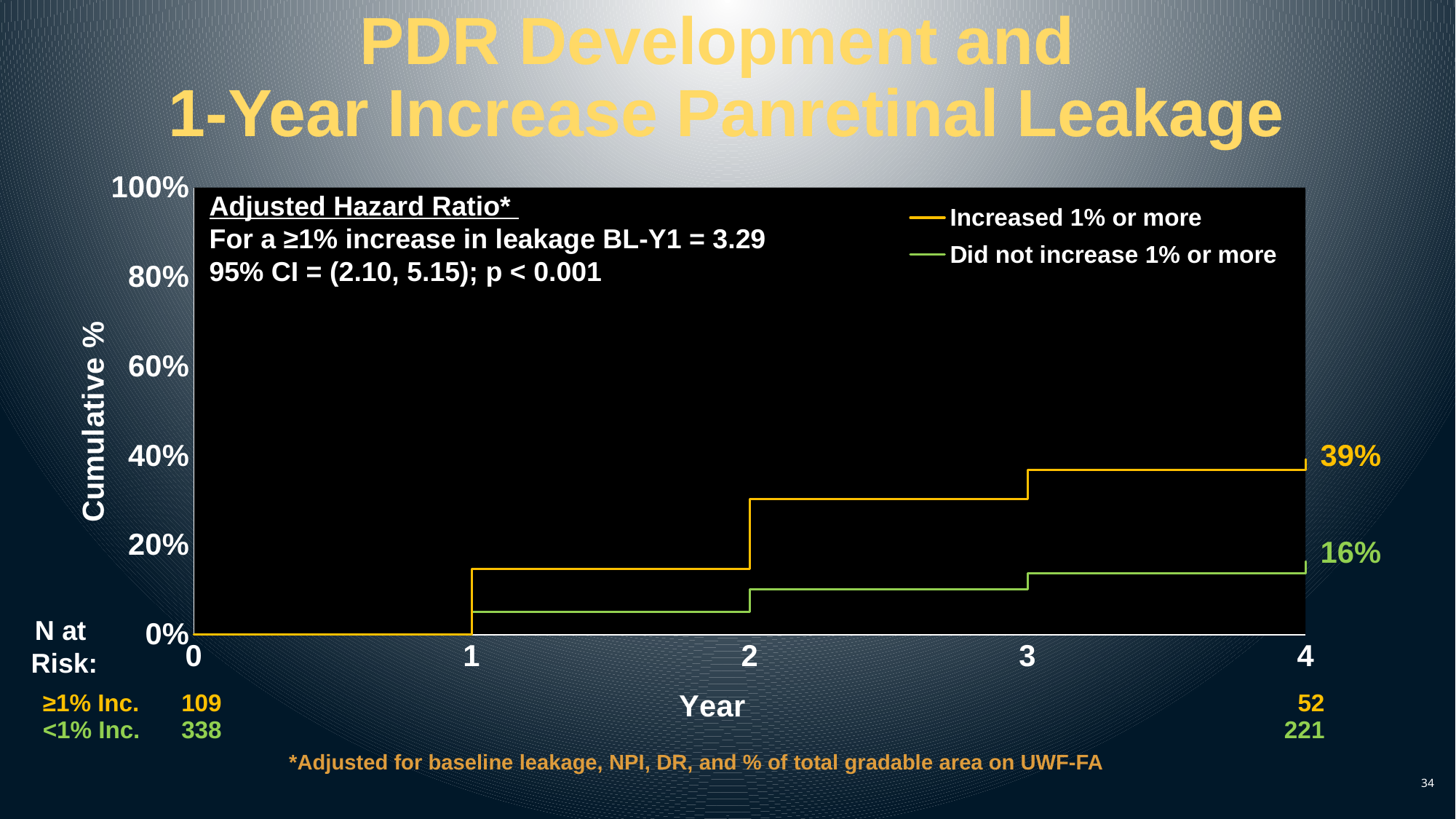
Which group has the higher cumulative % at year 4? Increased 1% or more What is the difference between the year-4 cumulative % of the 'Increased 1% or more' group and the 'Did not increase 1% or more' group? 23 percentage points Is the value for the 'Did not increase 1% or more' group at year 2 greater or less than 20%? less What is the cumulative % at year 4 for the 'Increased 1% or more' group? 39% How many year tick marks are shown on the x axis? 5 How many series does the legend list? 2 What colour is the line for the 'Did not increase 1% or more' group? Green What is the number at risk at year 0 for the ≥1% Inc. group? 109 Do the cumulative % values rise or fall as the year increases? Rise What is the cumulative % at year 4 for the 'Did not increase 1% or more' group? 16% What kind of chart is shown on the slide? Line chart